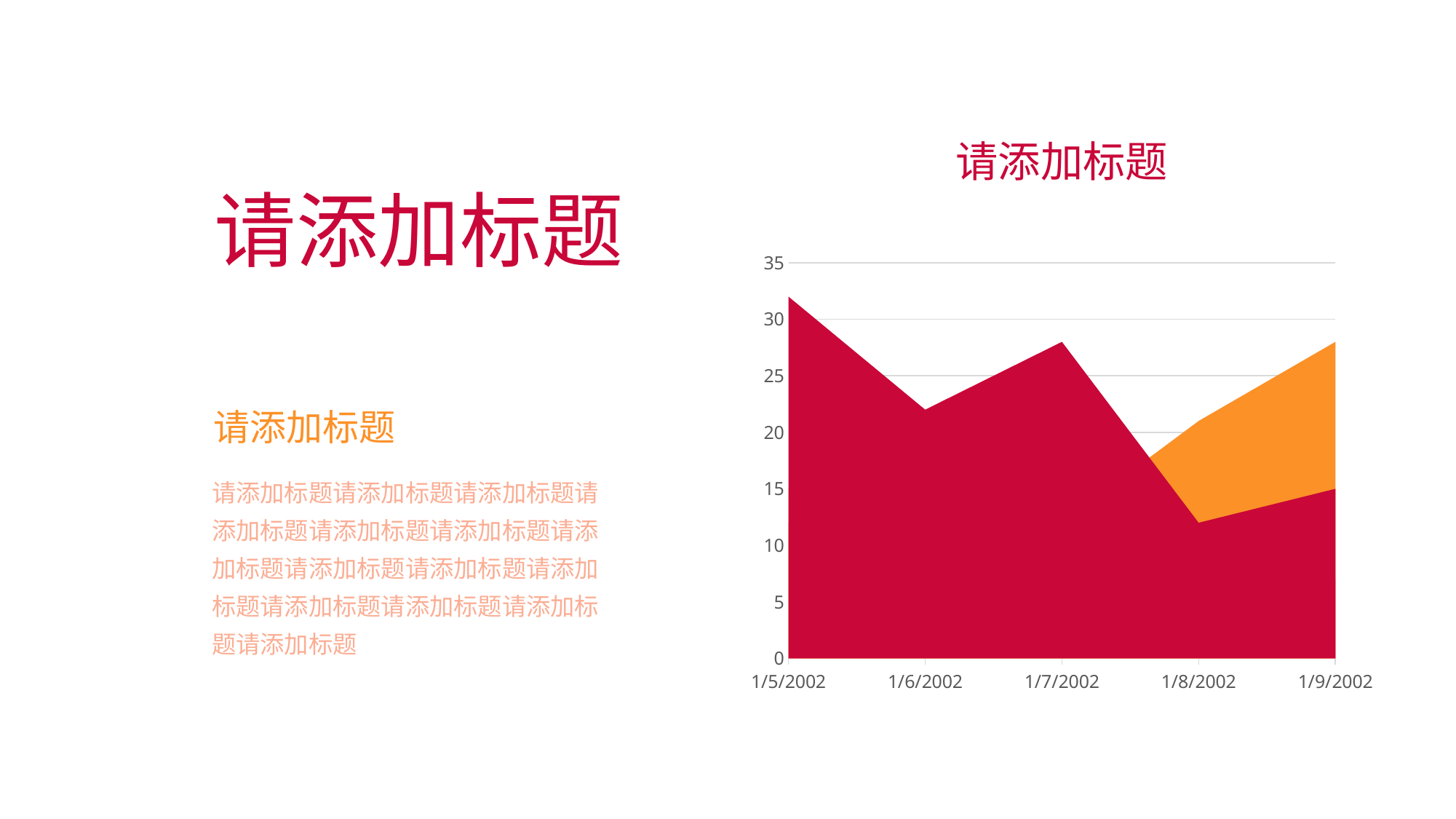
What kind of chart is shown on the slide? area chart On which date does the red series reach its highest value? 1/5/2002 How many dates are shown on the x axis of the chart? 5 What is the title of the chart? 请添加标题 Does the red series overall rise or fall from 1/5/2002 to 1/9/2002? fall What two colours are used for the areas in the chart? red and orange At 1/9/2002, which series has the larger value, the red series or the orange series? the orange series Is the value of the red series at 1/6/2002 greater or less than 25? less Is the value of the red series at 1/8/2002 greater or less than 15? less On which date does the red series reach its lowest value? 1/8/2002 Is the value of the orange series at 1/9/2002 greater or less than 25? greater